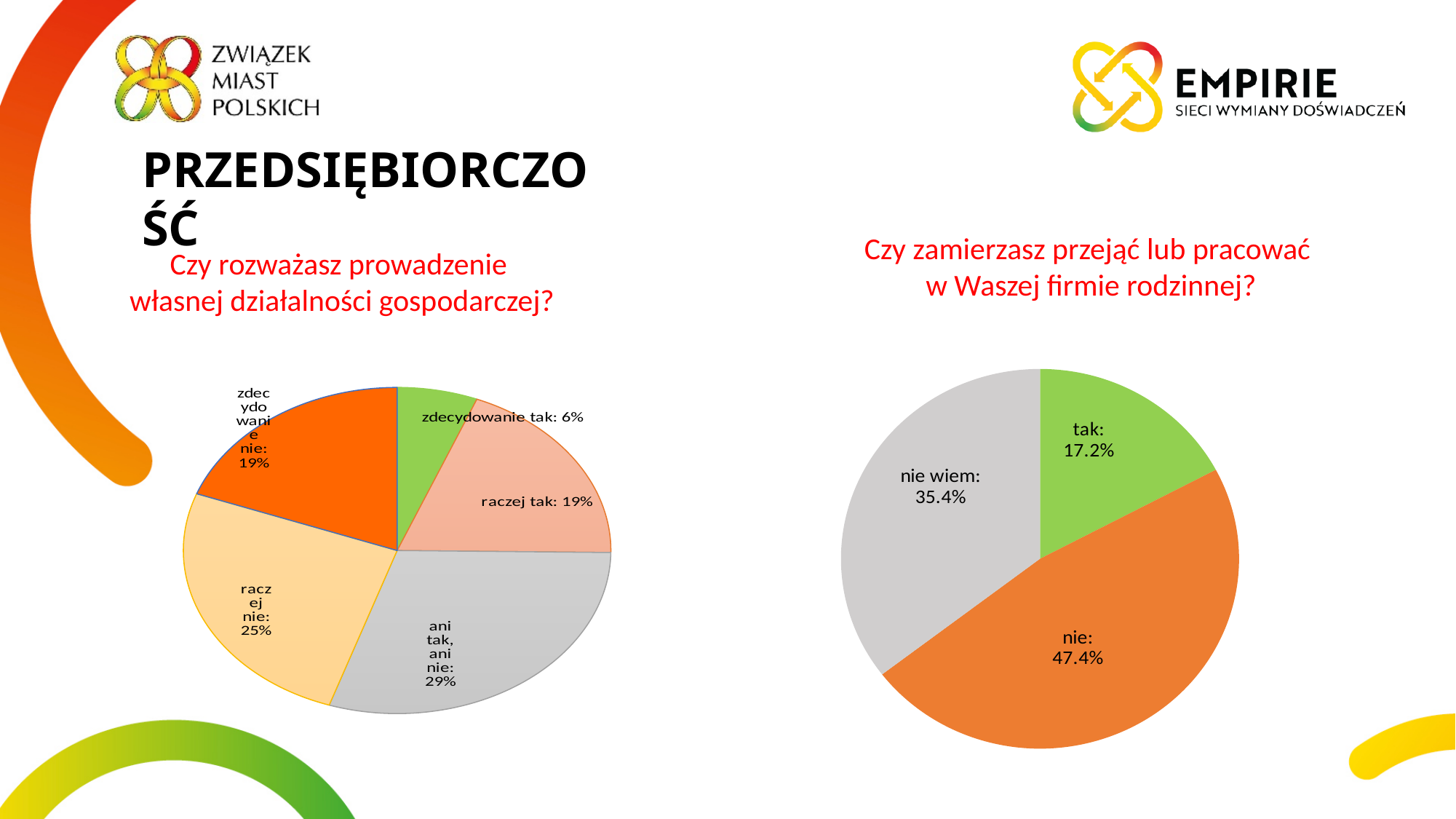
In the left pie chart, which category has the largest slice? ani tak, ani nie In the right pie chart, what share is labelled 'nie wiem'? 35.4% In the left pie chart, what share is labelled 'raczej nie'? 25% In the left pie chart, what share is labelled 'ani tak, ani nie'? 29% What type of chart is shown on the right side of the slide? Pie chart In the left pie chart, what is the difference between the 'raczej nie' share and the 'zdecydowanie nie' share? 6% In the left pie chart (Czy rozważasz prowadzenie własnej działalności gospodarczej?), what share is labelled 'zdecydowanie tak'? 6% In the right pie chart, which category has the smallest slice? tak In the left pie chart, which category has the smallest slice? zdecydowanie tak In the left pie chart, how many slices are there? 5 In the right pie chart, which is larger: 'nie' or 'nie wiem'? nie In the right pie chart (Czy zamierzasz przejąć lub pracować w Waszej firmie rodzinnej?), what share is labelled 'nie'? 47.4%